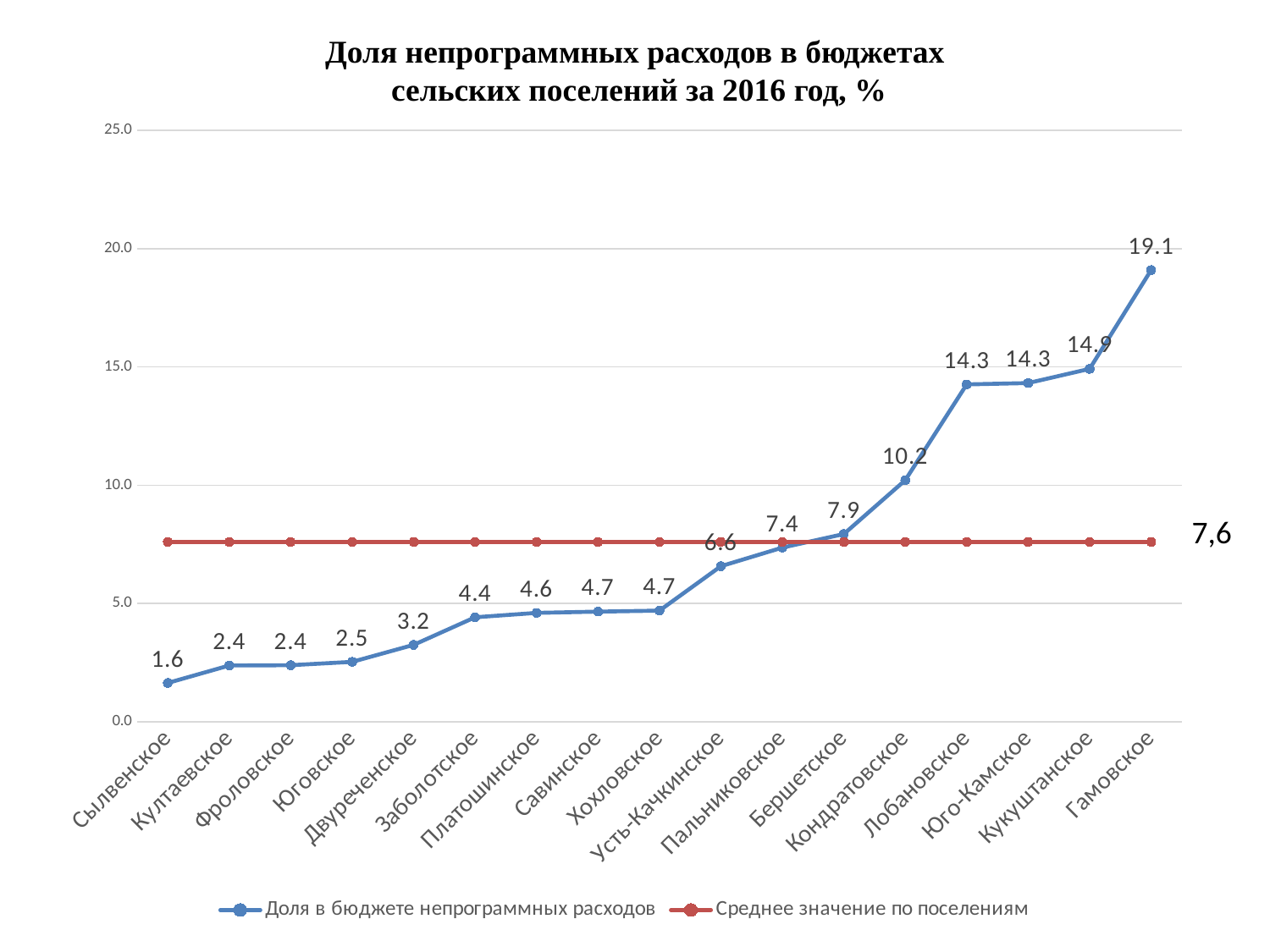
What is the value for Двуреченское in the series 'Доля в бюджете непрограммных расходов'? 3.2 What is the difference between the values for Гамовское and Кукуштанское? 4.2 Is the value for Лобановское greater or less than 10.0? greater Which settlement has the highest share of non-programme expenditures? Гамовское How many series does the legend list? 2 What is the value for Кондратовское in the series 'Доля в бюджете непрограммных расходов'? 10.2 Which is larger, the value for Усть-Качкинское or the value for Заболотское? Усть-Качкинское What kind of chart is shown on the slide? Line chart How many settlements are shown on the x axis? 17 What is the value for Гамовское in the series 'Доля в бюджете непрограммных расходов'? 19.1 What value is shown for the series 'Среднее значение по поселениям'? 7,6 Which settlement has the lowest share of non-programme expenditures? Сылвенское